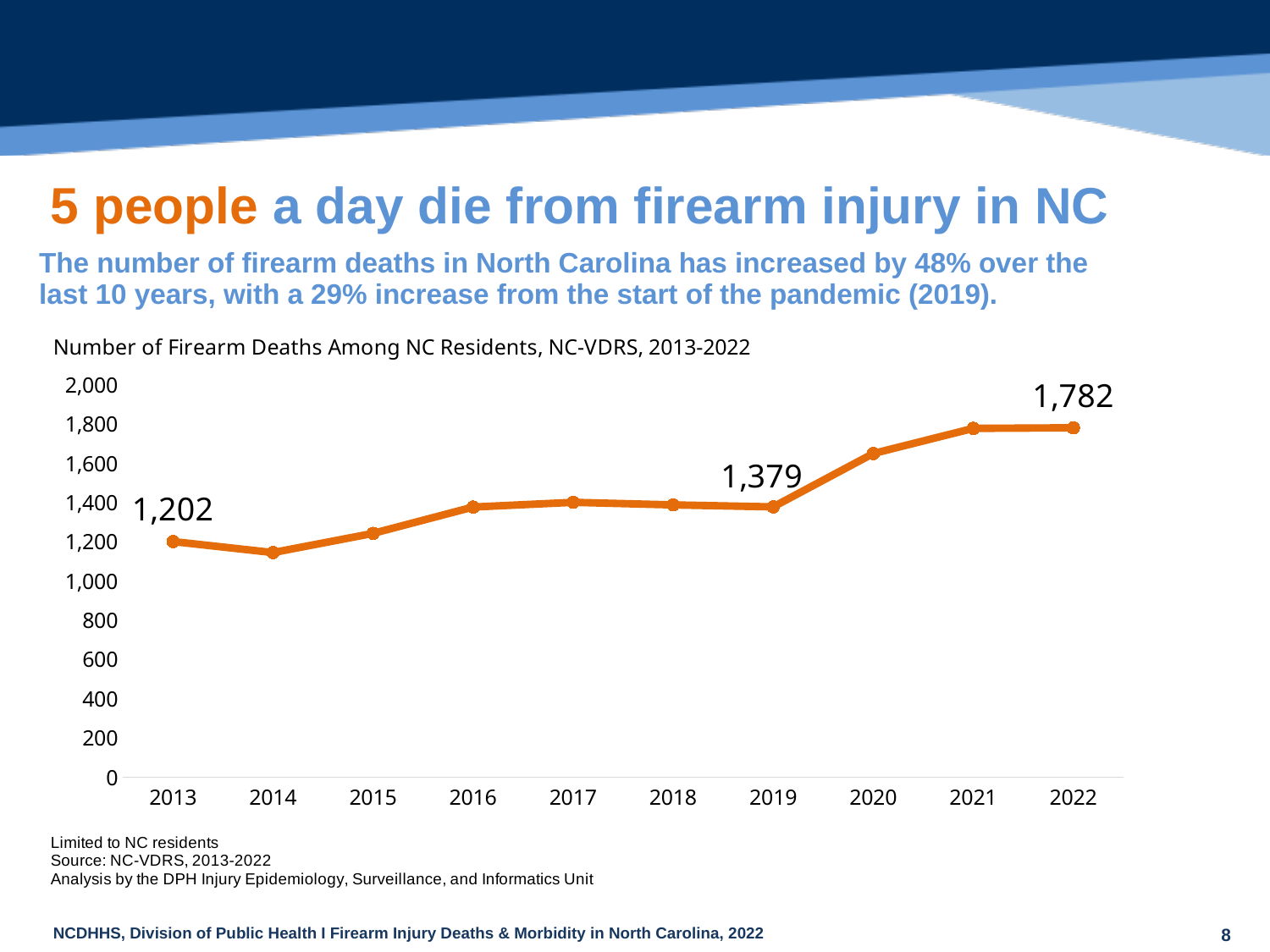
Which year had more firearm deaths, 2013 or 2019? 2019 Do the values generally rise or fall from 2013 to 2022? Rise What is the difference between the number of firearm deaths in 2022 and in 2019? 403 How many years are plotted on the chart? 10 Is the value for 2020 greater or less than 1,600? greater Which year has the lowest number of firearm deaths? 2014 What type of chart is shown on the slide? Line chart What is the number of firearm deaths among NC residents in 2022? 1,782 What is the number of firearm deaths among NC residents in 2013? 1,202 What is the difference between the number of firearm deaths in 2022 and in 2013? 580 What is the number of firearm deaths among NC residents in 2019? 1,379